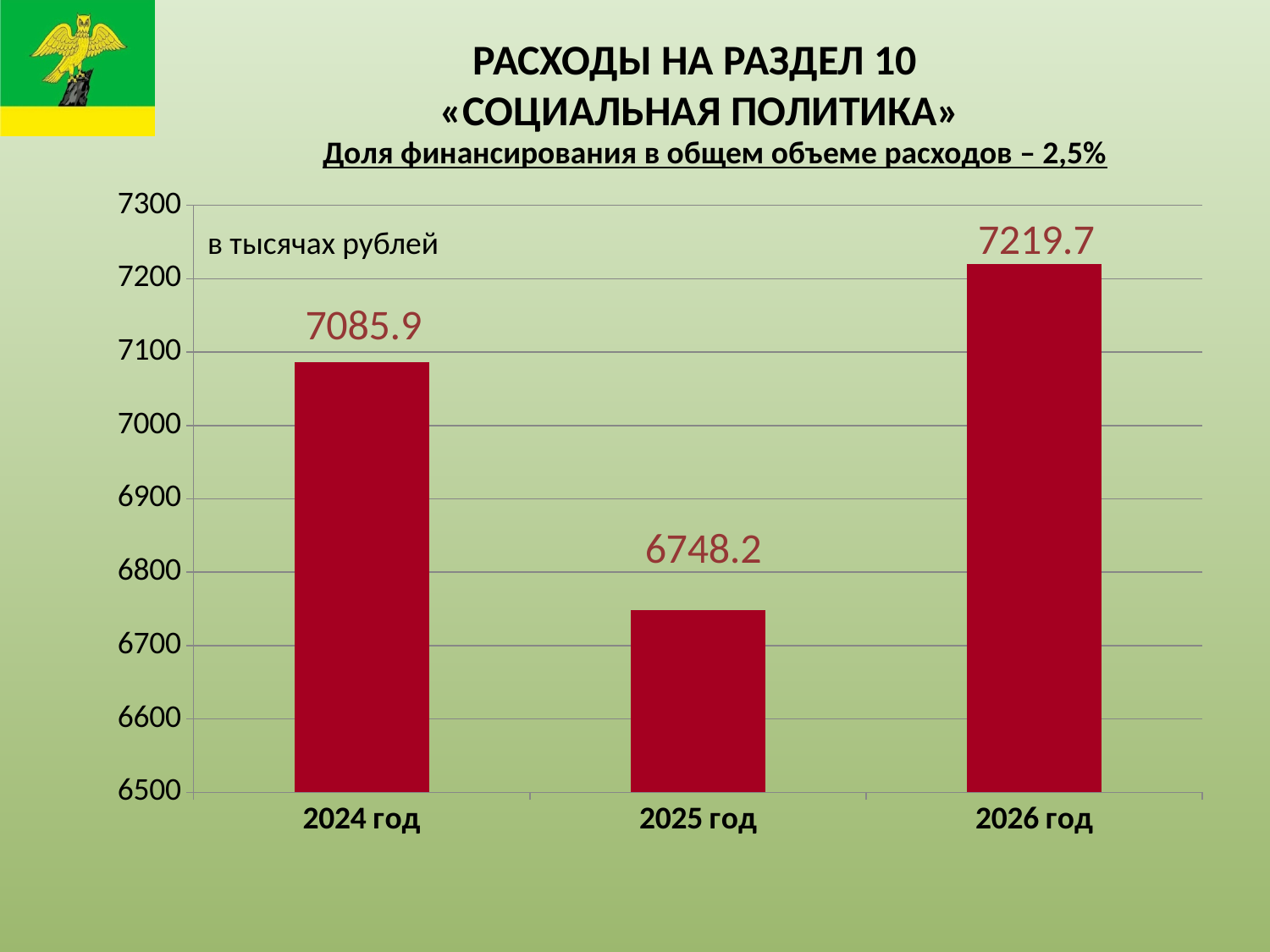
Which is larger, the value for 2024 год or the value for 2026 год? 2026 год What is the value for 2026 год? 7219.7 What is the difference between the values for 2024 год and 2025 год? 337.7 Is the value for 2025 год greater or less than 6800? less How many years are shown on the chart? 3 What kind of chart is shown on the slide? bar chart In what units are the values on the chart given, according to the note on the chart? в тысячах рублей Which year has the lowest value? 2025 год What is the value for 2024 год? 7085.9 Which year has the highest value? 2026 год What is the value for 2025 год? 6748.2 What is the difference between the values for 2026 год and 2025 год? 471.5